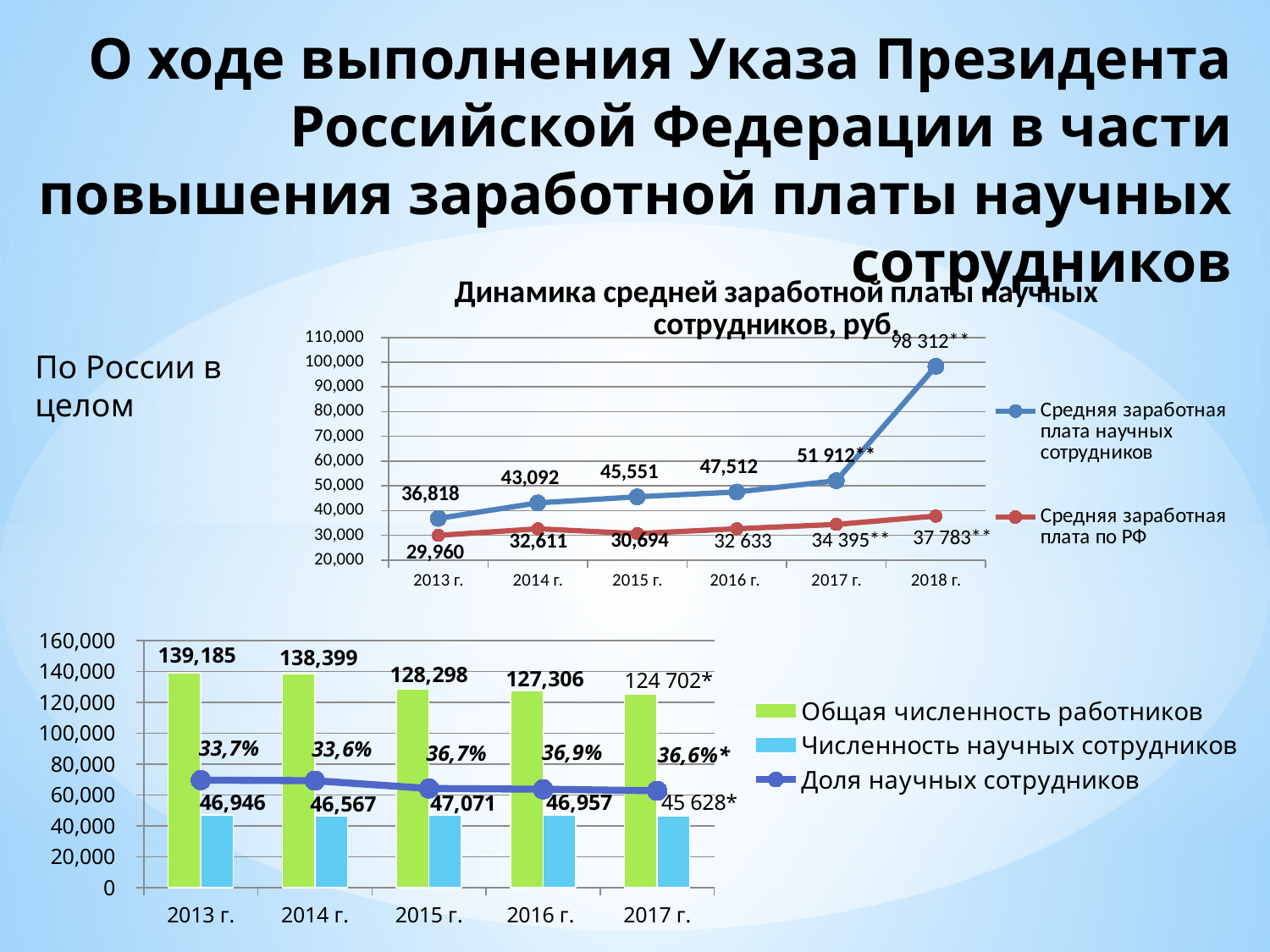
In the bottom chart, in which year is 'Численность научных сотрудников' highest? 2015 г. In the bottom chart, does 'Общая численность работников' rise or fall from 2013 г. to 2017 г.? fall In the top chart 'Динамика средней заработной платы научных сотрудников, руб.', in which year is 'Средняя заработная плата по РФ' lowest? 2013 г. In the top chart 'Динамика средней заработной платы научных сотрудников, руб.', how many series does the legend list? 2 In the top chart 'Динамика средней заработной платы научных сотрудников, руб.', in which year is 'Средняя заработная плата научных сотрудников' highest? 2018 г. In the bottom chart, what is the value of 'Общая численность работников' for 2015 г.? 128,298 In the bottom chart, which is larger: 'Общая численность работников' in 2013 г. or in 2014 г.? 2013 г. In the top chart 'Динамика средней заработной платы научных сотрудников, руб.', how many years are shown on the x axis? 6 In the top chart 'Динамика средней заработной платы научных сотрудников, руб.', what is the difference between 'Средняя заработная плата научных сотрудников' and 'Средняя заработная плата по РФ' in 2013 г.? 6,858 In the bottom chart, what is the value of 'Доля научных сотрудников' for 2016 г.? 36,9% In the top chart 'Динамика средней заработной платы научных сотрудников, руб.', what is the value of 'Средняя заработная плата по РФ' for 2016 г.? 32 633 In the top chart 'Динамика средней заработной платы научных сотрудников, руб.', what is the value of 'Средняя заработная плата научных сотрудников' for 2014 г.? 43,092